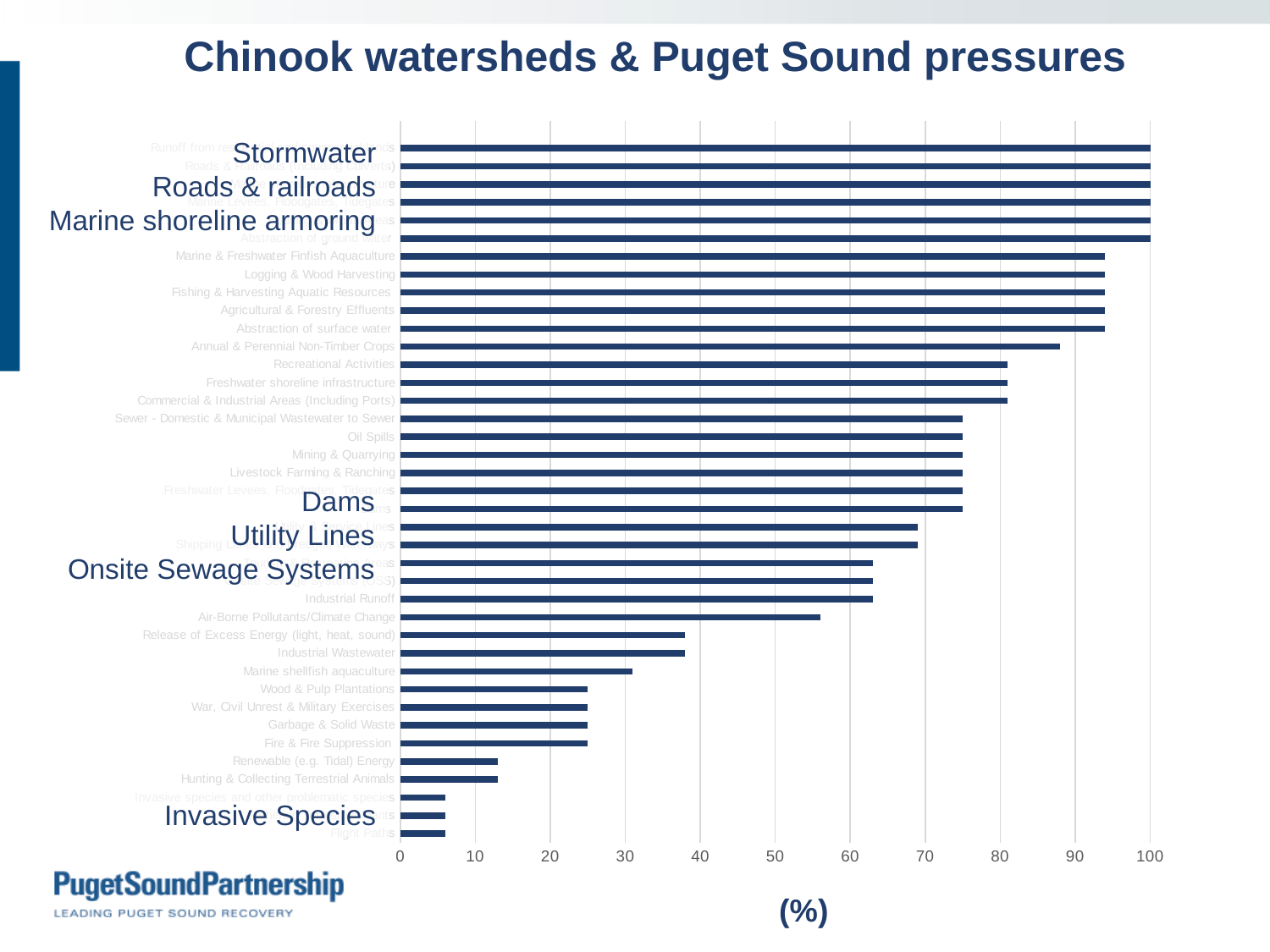
Is the value for Industrial Wastewater greater or less than 50? less What value on the axis do the longest bars in the chart reach? 100 Which has the larger value, Oil Spills or Industrial Wastewater? Oil Spills Is the value for Flight Paths greater or less than 10? less What label is shown on the horizontal axis of the chart? (%) Is the value for Renewable (e.g. Tidal) Energy greater or less than 20? less Which has the larger value, Garbage & Solid Waste or Flight Paths? Garbage & Solid Waste What is the title of the chart? Chinook watersheds & Puget Sound pressures What kind of chart is shown on the slide? bar chart